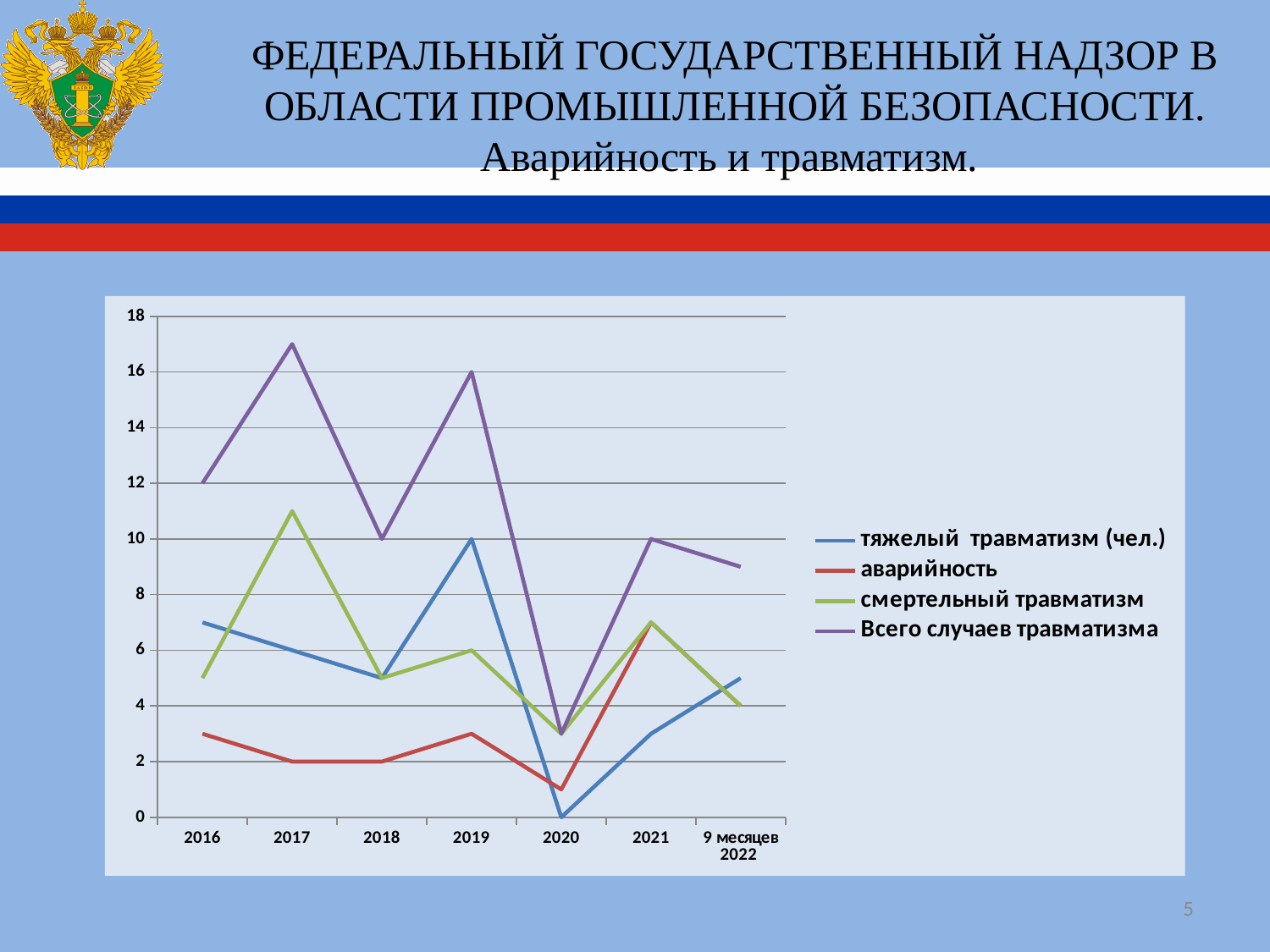
What kind of chart is shown on the slide? line chart In which year does "Всего случаев травматизма" reach its highest value? 2017 What is the value of "аварийность" in 2017? 2 How many series does the legend list? 4 By how much does "Всего случаев травматизма" in 2019 exceed its value in 2016? 4 How many categories are shown along the x axis? 7 What is the value of "тяжелый травматизм (чел.)" in 2020? 0 What is the value of "Всего случаев травматизма" in 2019? 16 What is the value of "Всего случаев травматизма" in 2016? 12 What is the value of "тяжелый травматизм (чел.)" in 2019? 10 Is the value of "Всего случаев травматизма" in 2017 greater or less than 16? greater Which is larger in 2019: "тяжелый травматизм (чел.)" or "смертельный травматизм"? тяжелый травматизм (чел.)